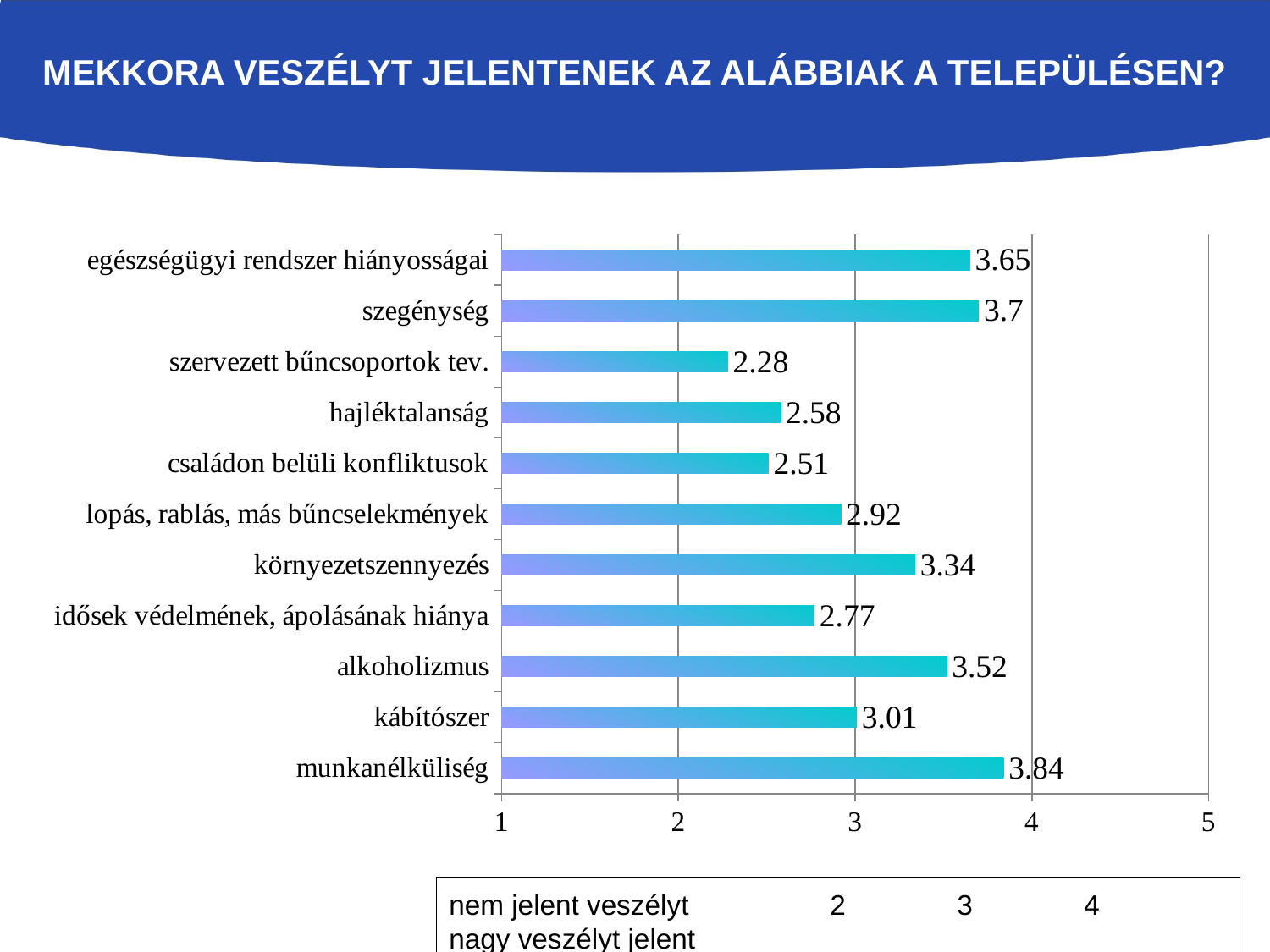
What is the value for környezetszennyezés? 3.34 What is the maximum value shown on the horizontal axis? 5 What kind of chart is shown on the slide? bar chart How many categories are shown in the chart? 11 What is the difference between the values for szegénység and alkoholizmus? 0.18 What is the value for munkanélküliség? 3.84 Which category has the lowest value? szervezett bűncsoportok tev. What is the value for kábítószer? 3.01 Which is larger, the value for hajléktalanság or the value for idősek védelmének, ápolásának hiánya? idősek védelmének, ápolásának hiánya Which category has the highest value? munkanélküliség Is the value for lopás, rablás, más bűncselekmények greater or less than 3? less What is the value for szervezett bűncsoportok tev.? 2.28